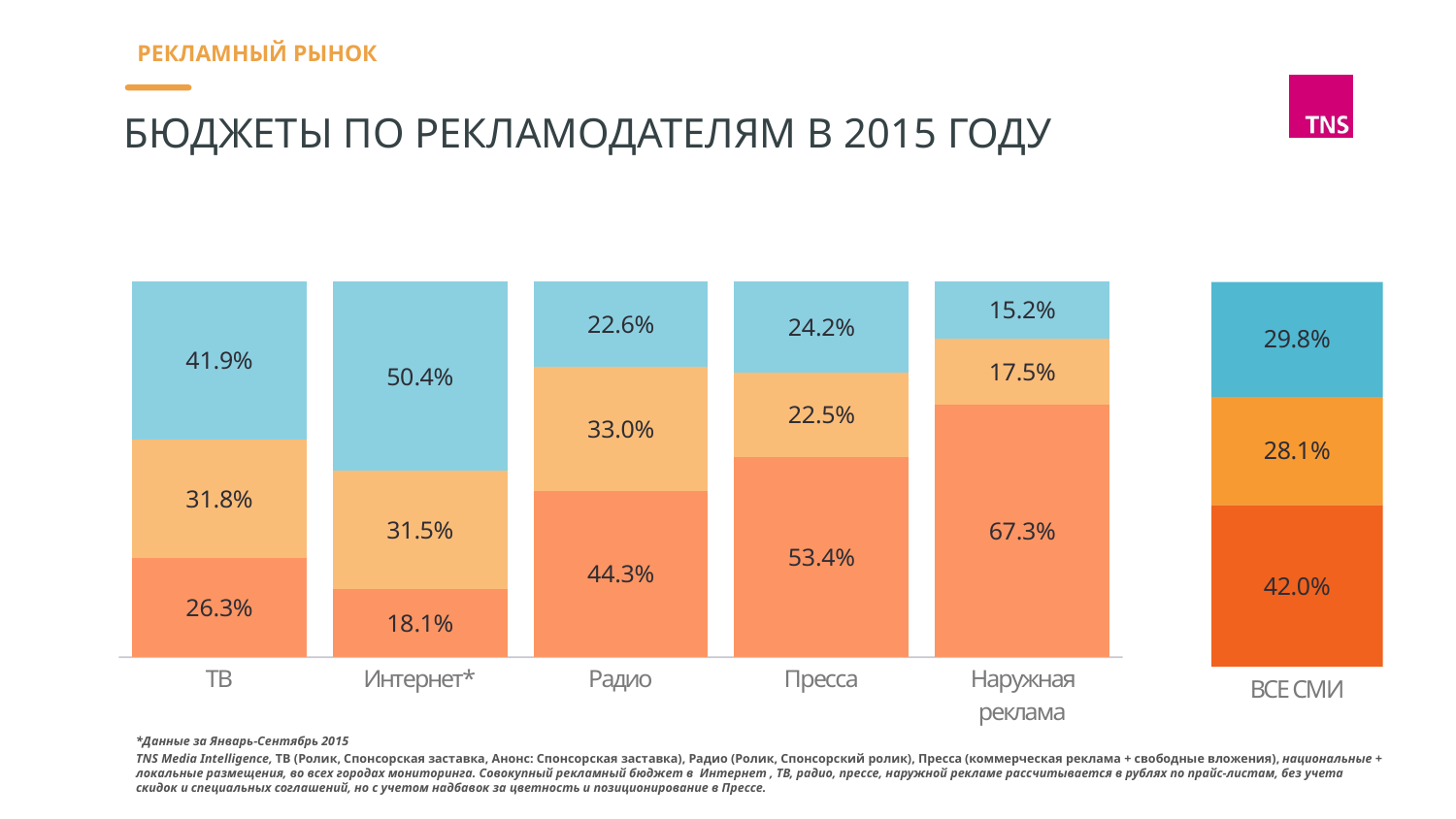
What is the title of the slide's chart? БЮДЖЕТЫ ПО РЕКЛАМОДАТЕЛЯМ В 2015 ГОДУ In the left chart, what is the value of the bottom (dark orange) segment for ТВ? 26.3% In the left chart, which is larger: the top segment for Пресса or the top segment for Наружная реклама? Пресса In the left chart, which category has the largest top (light blue) segment? Интернет* In the left chart, what is the value of the bottom segment for Наружная реклама? 67.3% In the left chart, what is the value of the top (light blue) segment for Интернет*? 50.4% In the left chart, which category has the smallest bottom (dark orange) segment? Интернет* In the left chart, what is the difference between the bottom segment values for Пресса and Радио? 9.1% In the left chart, how many categories are shown on the x axis? 5 In the left chart, what is the value of the middle (light orange) segment for Радио? 33.0% What type of chart is shown on the slide? Stacked bar chart In the right chart (ВСЕ СМИ), what is the value of the bottom segment? 42.0%